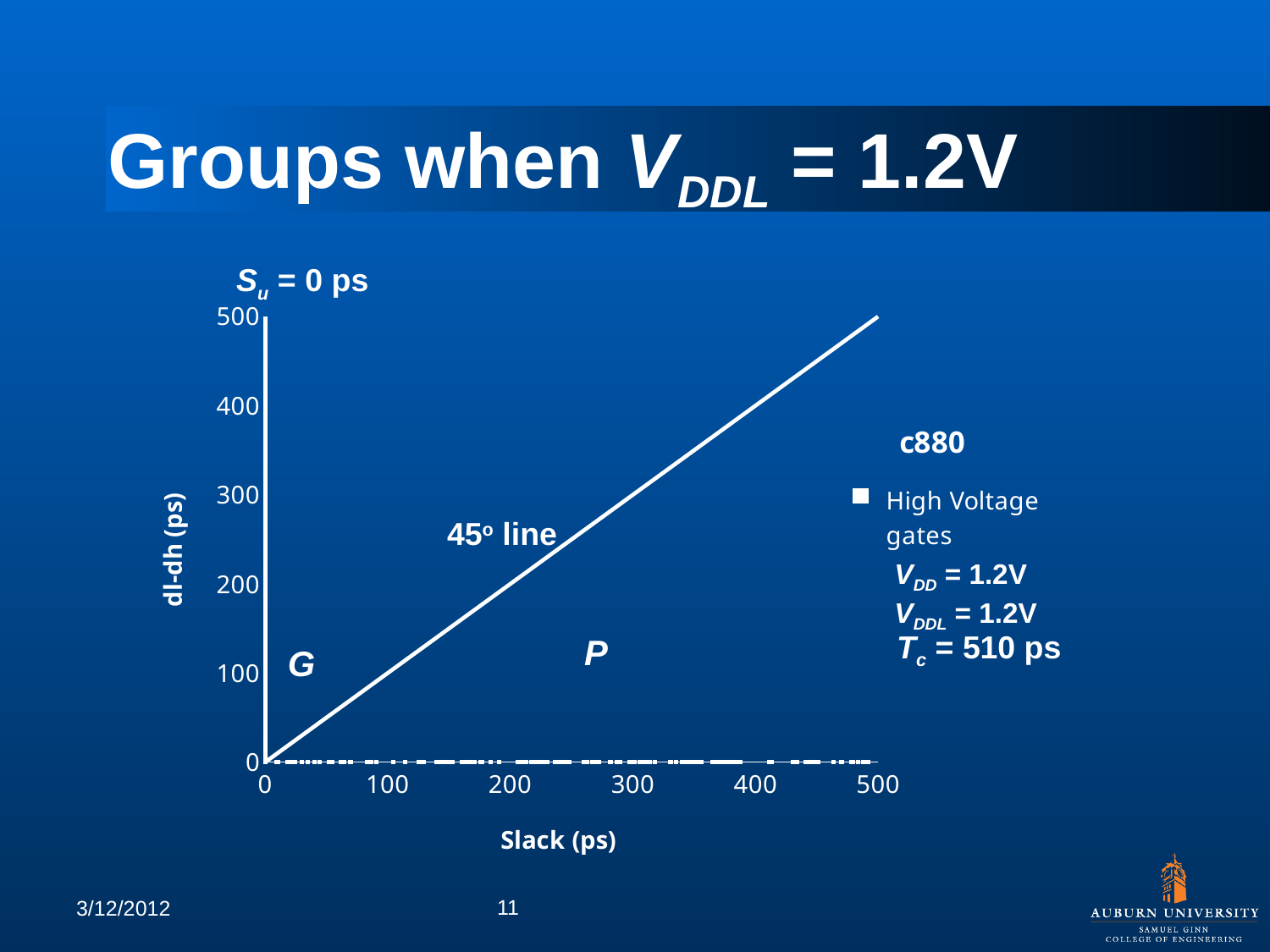
What is the legend entry for the plotted points? High Voltage gates Do the plotted dl-dh values rise, fall, or stay flat as Slack increases along the x axis? stay flat What kind of chart is shown on the slide? scatter chart What is the label of the x axis? Slack (ps) What is the highest value shown on the y axis? 500 What is the highest value shown on the x axis? 500 How many series does the chart's legend list? 1 What is the title of the chart? c880 Are the dl-dh values of the plotted points greater or less than 100 ps? less Do the plotted points lie above or below the 45° line? below What is the label of the y axis? dl-dh (ps) What value of Tc is stated next to the chart? 510 ps